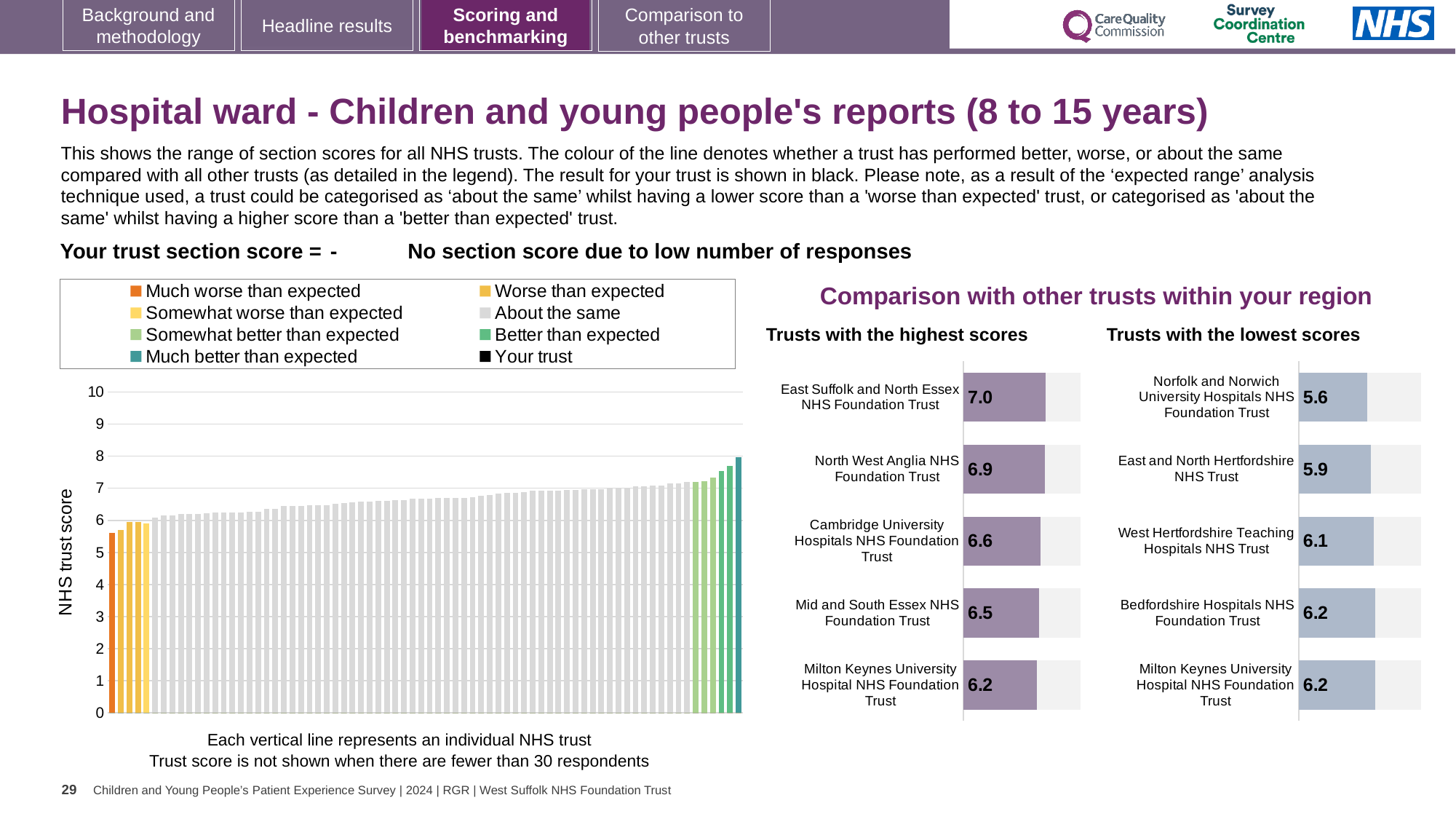
In the 'Trusts with the highest scores' chart, what is the score for East Suffolk and North Essex NHS Foundation Trust? 7.0 In the 'Trusts with the highest scores' chart, which has the larger score: North West Anglia NHS Foundation Trust or Mid and South Essex NHS Foundation Trust? North West Anglia NHS Foundation Trust In the 'Trusts with the lowest scores' chart, which trust has the lowest score? Norfolk and Norwich University Hospitals NHS Foundation Trust In the 'Trusts with the lowest scores' chart, what is the score for Norfolk and Norwich University Hospitals NHS Foundation Trust? 5.6 In the 'Trusts with the lowest scores' chart, what is the difference between the scores of West Hertfordshire Teaching Hospitals NHS Trust and Norfolk and Norwich University Hospitals NHS Foundation Trust? 0.5 What kind of chart is the NHS trust score chart on the left of the slide? Bar chart In the 'Trusts with the highest scores' chart, what is the difference between the scores of East Suffolk and North Essex NHS Foundation Trust and Milton Keynes University Hospital NHS Foundation Trust? 0.8 In the 'Trusts with the highest scores' chart, what is the score for Cambridge University Hospitals NHS Foundation Trust? 6.6 How many entries does the legend of the NHS trust score chart on the left list? 8 In the NHS trust score chart on the left, do the bar values rise or fall from left to right? Rise In the 'Trusts with the highest scores' chart, which trust has the highest score? East Suffolk and North Essex NHS Foundation Trust How many trusts are shown in the 'Trusts with the lowest scores' chart? 5